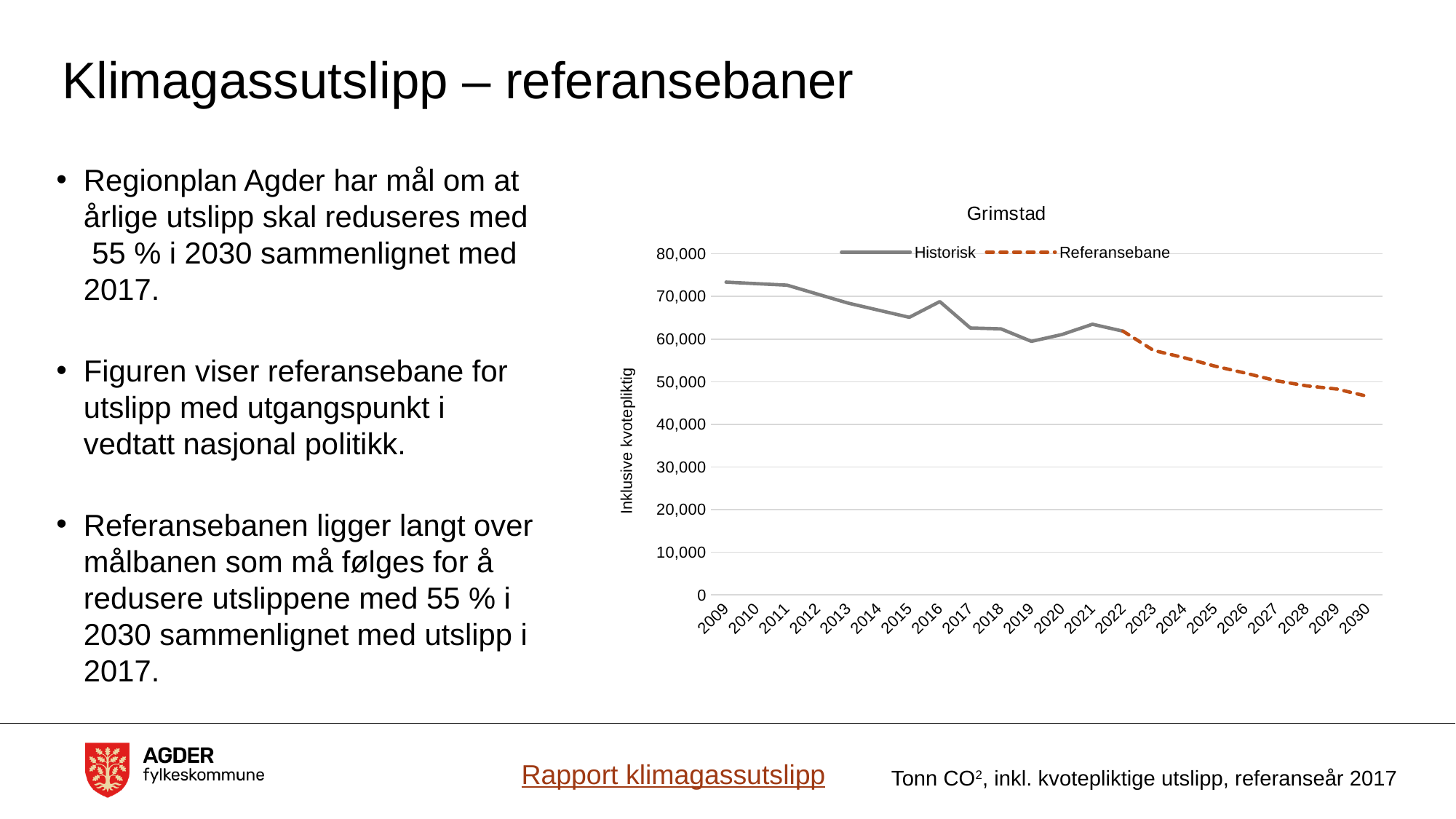
Is the value for 2023 greater or less than 60,000? less Is the value for 2009 greater or less than 70,000? greater What is the title of the chart? Grimstad Do the values generally rise or fall from 2009 to 2030? fall Which year has the larger value, 2015 or 2016? 2016 Is the value for 2030 greater or less than 50,000? less Which series is drawn with a dashed line? Referansebane Which year has the larger value, 2009 or 2030? 2009 How many series does the chart legend list? 2 Which year has the lowest value on the chart? 2030 How many years are shown on the x axis of the chart? 22 What kind of chart is shown on the slide? line chart